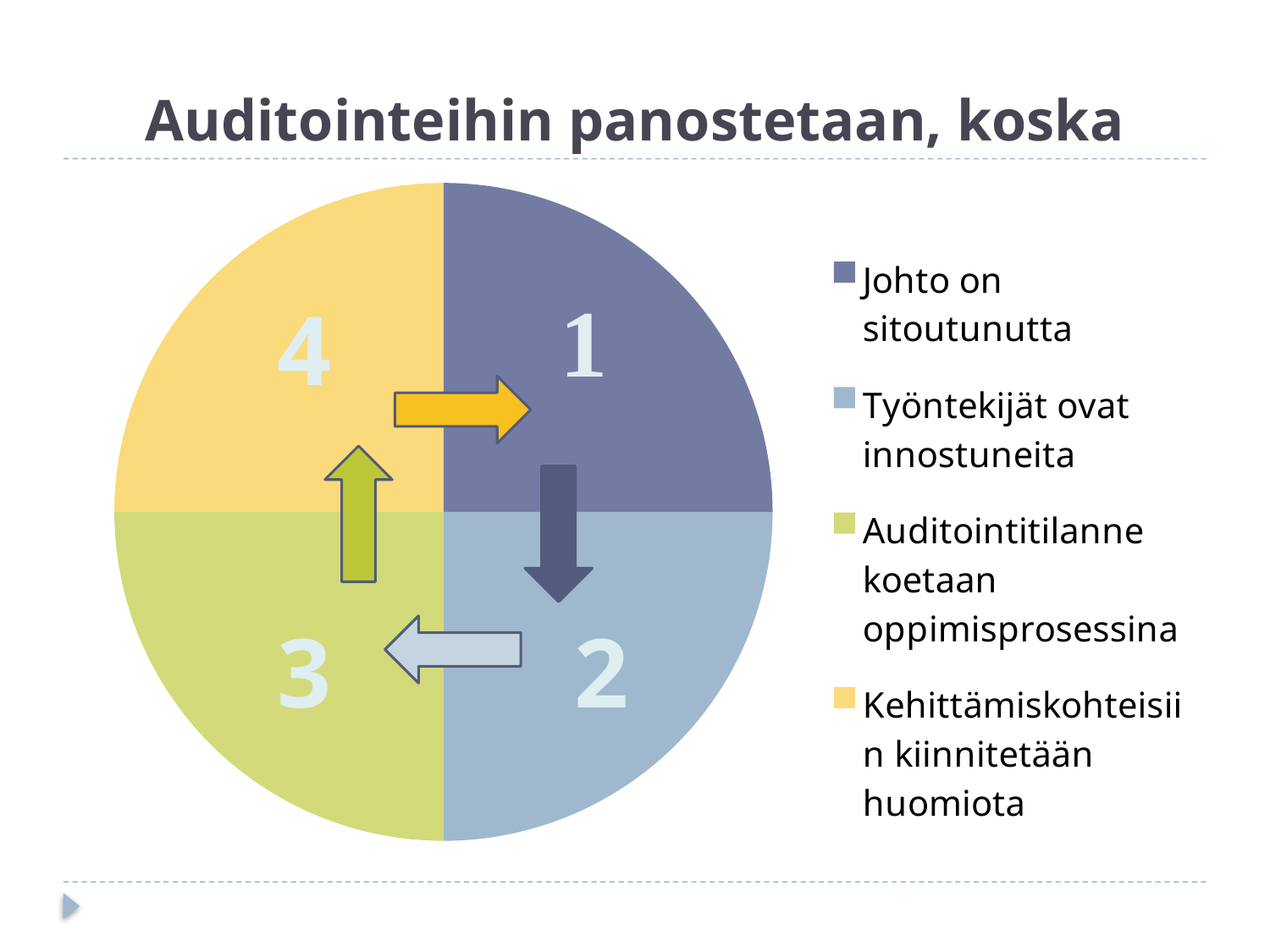
Which legend entry corresponds to the slice numbered 2? Työntekijät ovat innostuneita What kind of chart is shown on the slide? pie chart Which legend entry corresponds to the slice numbered 3? Auditointitilanne koetaan oppimisprosessina How many entries does the legend list? 4 How many slices does the pie chart have? 4 Which legend entry corresponds to the slice numbered 4? Kehittämiskohteisiin kiinnitetään huomiota What is the title of the slide containing the pie chart? Auditointeihin panostetaan, koska What number is printed on the yellow slice of the pie chart? 4 What colour is the slice labelled 'Johto on sitoutunutta'? dark blue Which legend entry corresponds to the slice numbered 1? Johto on sitoutunutta